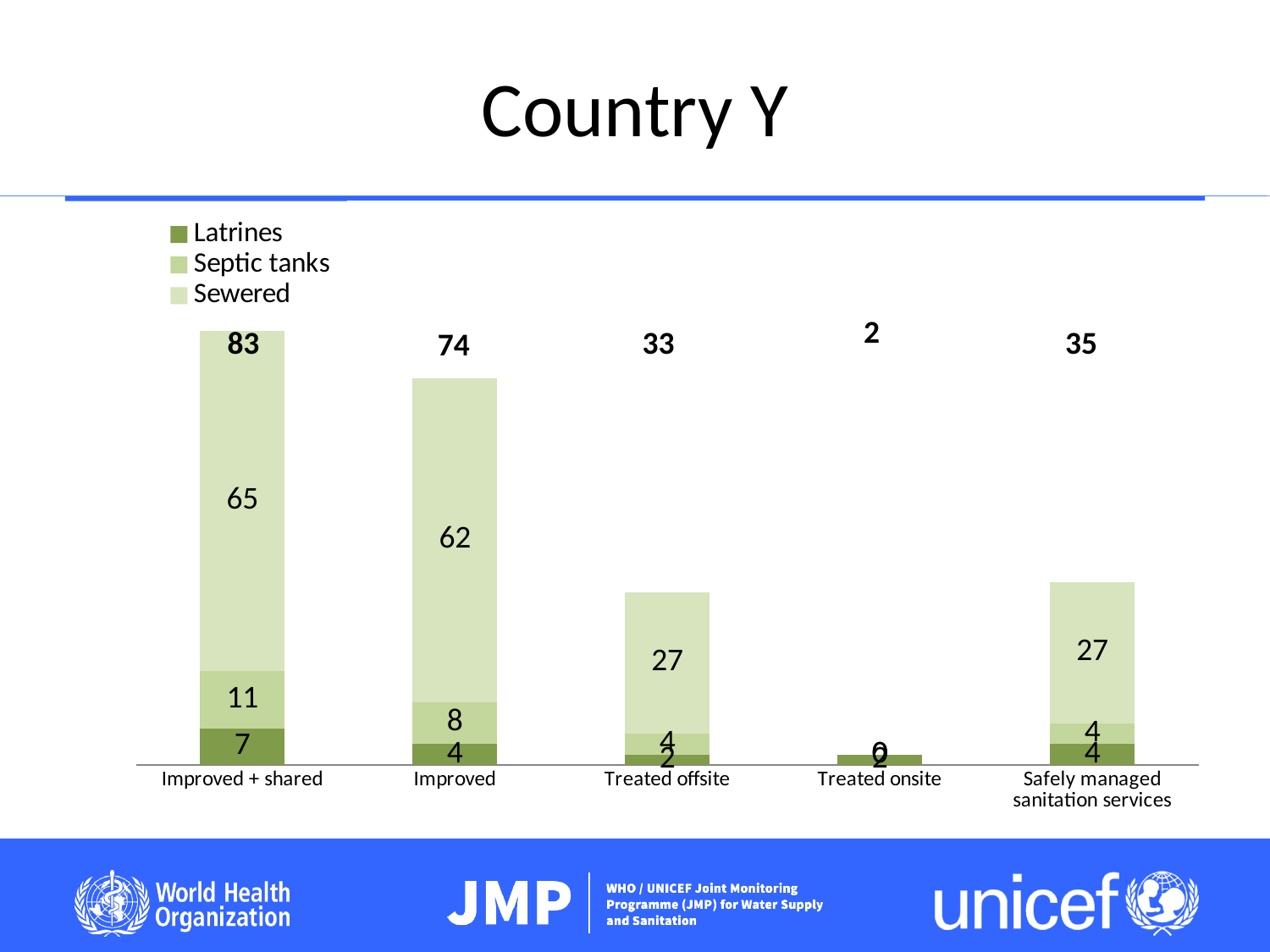
What is the total of the stacked bar for Treated offsite? 33 What is the title of the slide containing the chart? Country Y What type of chart is shown on the slide? Stacked bar chart Which category has the lowest stacked total? Treated onsite What is the Sewered value for Improved + shared? 65 What is the Latrines value for Safely managed sanitation services? 4 How many series does the legend list? 3 What is the Septic tanks value for Improved? 8 Which category has the highest stacked total? Improved + shared What is the difference between the Sewered values for Improved + shared and Improved? 3 How many categories are shown on the x axis? 5 Which is larger, the total for Safely managed sanitation services or the total for Treated offsite? Safely managed sanitation services